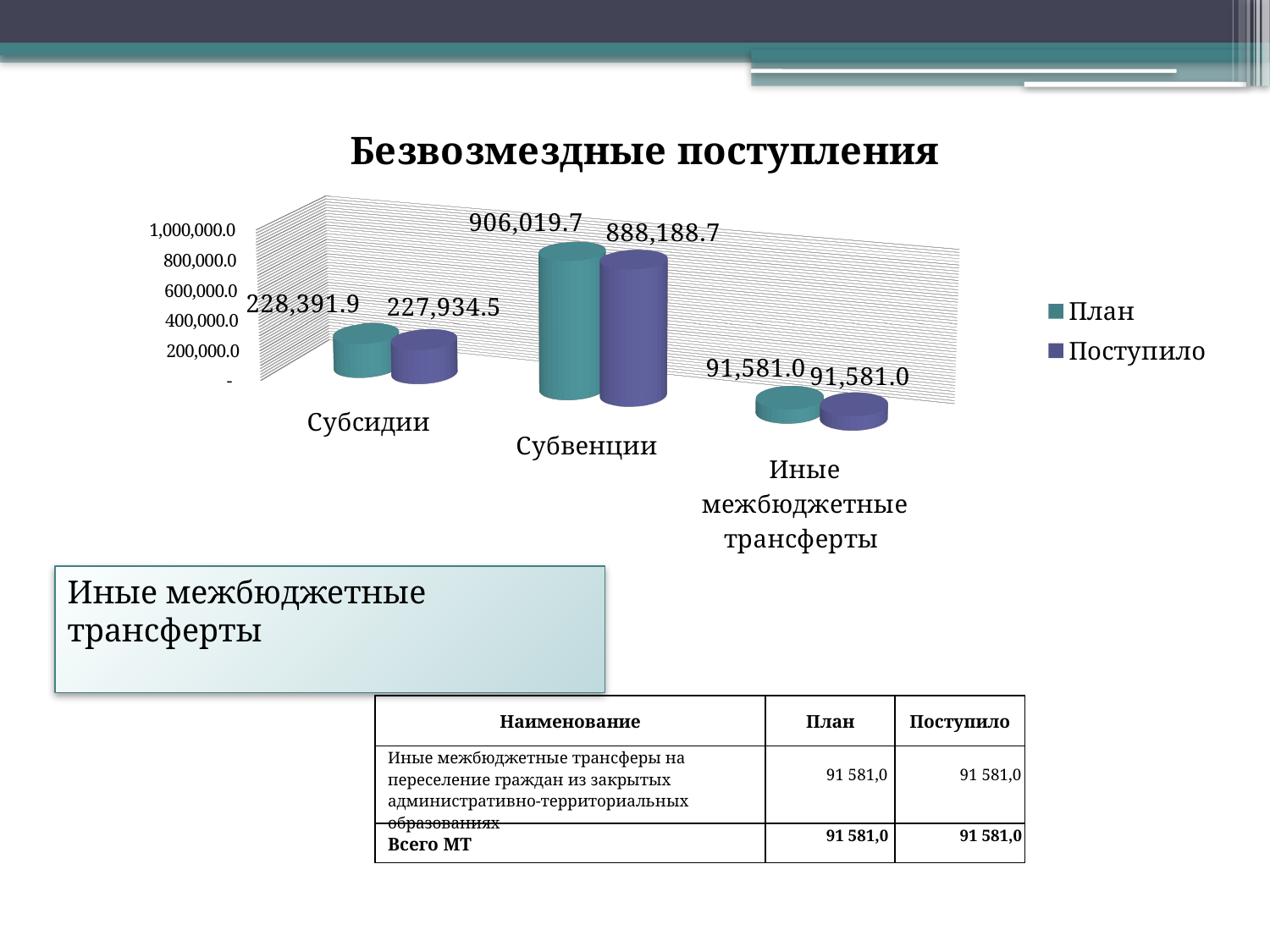
What is the Поступило value for Иные межбюджетные трансферты? 91,581.0 What is the difference between the План and Поступило values for Субвенции? 17,831.0 Which is larger: the План value for Субсидии or the План value for Иные межбюджетные трансферты? План value for Субсидии How many series does the chart legend list? 2 What is the Поступило value for Субсидии? 227,934.5 Which category has the highest План value? Субвенции What is the План value for Субвенции? 906,019.7 Is the Поступило value for Субвенции greater or less than 800,000.0? greater Which category has the lowest Поступило value? Иные межбюджетные трансферты What kind of chart is shown on the slide? bar chart How many categories are shown on the x axis of the chart? 3 What is the title of the chart? Безвозмездные поступления